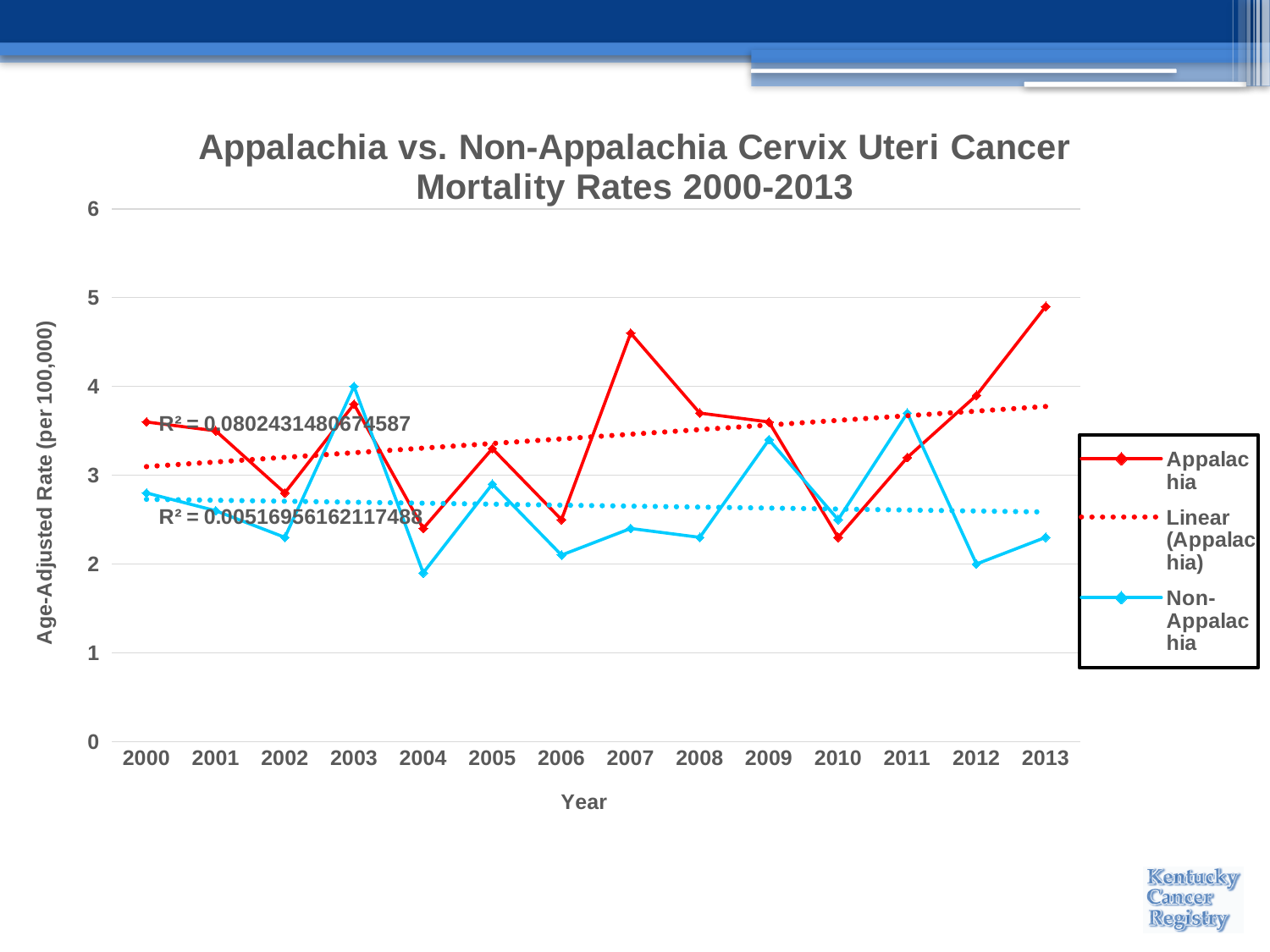
How many years are shown on the x axis of the chart? 14 Is the Non-Appalachia value for 2006 greater or less than 3? less What is the title of the chart? Appalachia vs. Non-Appalachia Cervix Uteri Cancer Mortality Rates 2000-2013 What type of chart is shown on the slide? line chart In which year is the Non-Appalachia mortality rate highest? 2003 Does the Linear (Appalachia) trendline rise or fall from 2000 to 2013? rise Is the Appalachia value for 2013 greater or less than 4? greater How many entries does the chart legend list? 3 Is the Appalachia value for 2010 greater or less than 3? less In which year is the Appalachia mortality rate highest? 2013 In 2011, which series has the higher mortality rate, Appalachia or Non-Appalachia? Non-Appalachia In 2007, which series has the higher mortality rate, Appalachia or Non-Appalachia? Appalachia